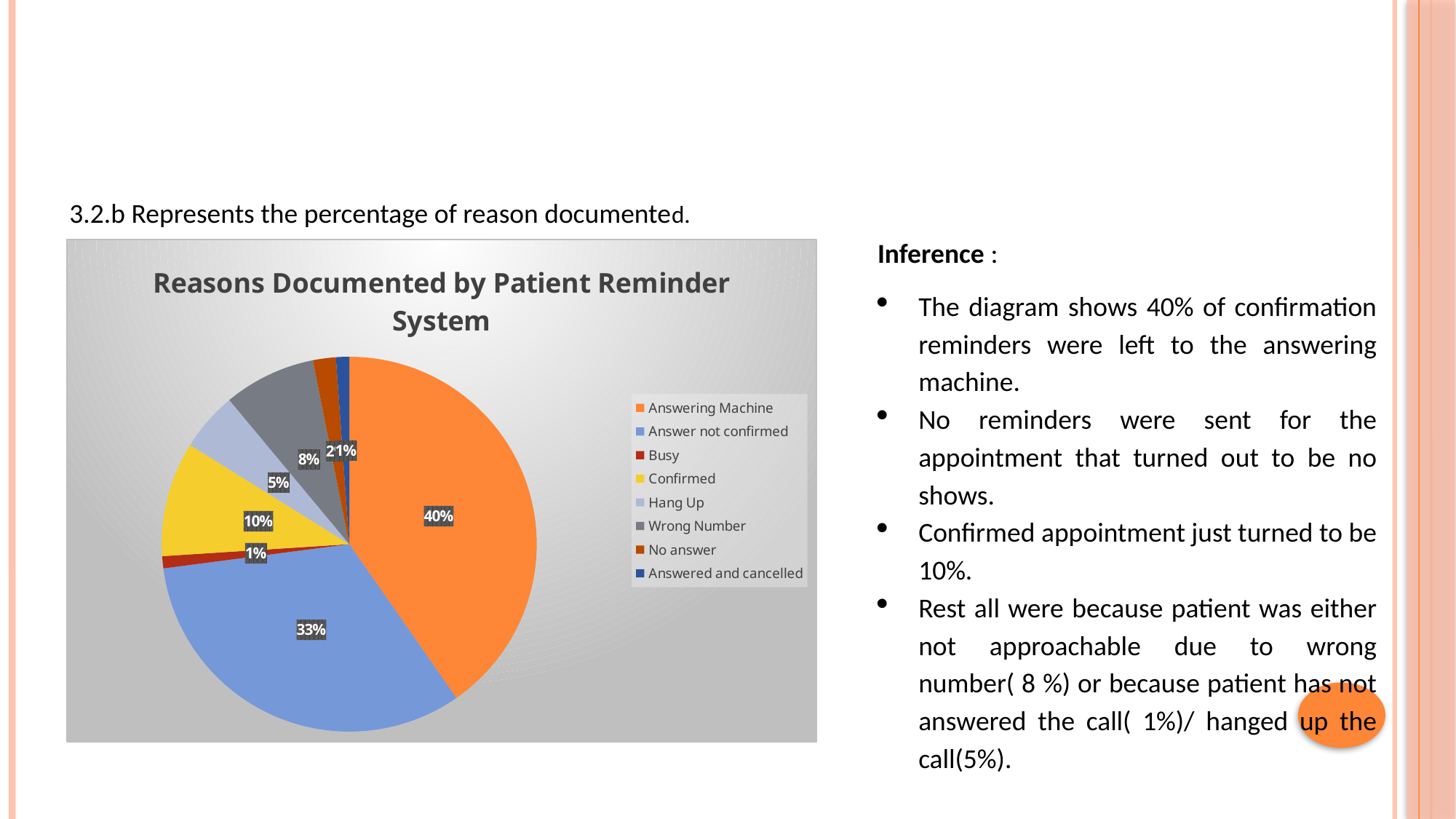
What is the title of the chart? Reasons Documented by Patient Reminder System What percentage of the pie is Answer not confirmed? 33% How many categories does the legend of the pie chart list? 8 What percentage of the pie is Confirmed? 10% What percentage of the pie is Hang Up? 5% What percentage of the pie is Answering Machine? 40% What percentage of the pie is Wrong Number? 8% Which category has the largest slice of the pie? Answering Machine What is the difference in percentage points between Answering Machine and Answer not confirmed? 7% Which slice is larger, Confirmed or Hang Up? Confirmed What kind of chart is shown on the slide? pie chart What percentage of the pie is Busy? 1%